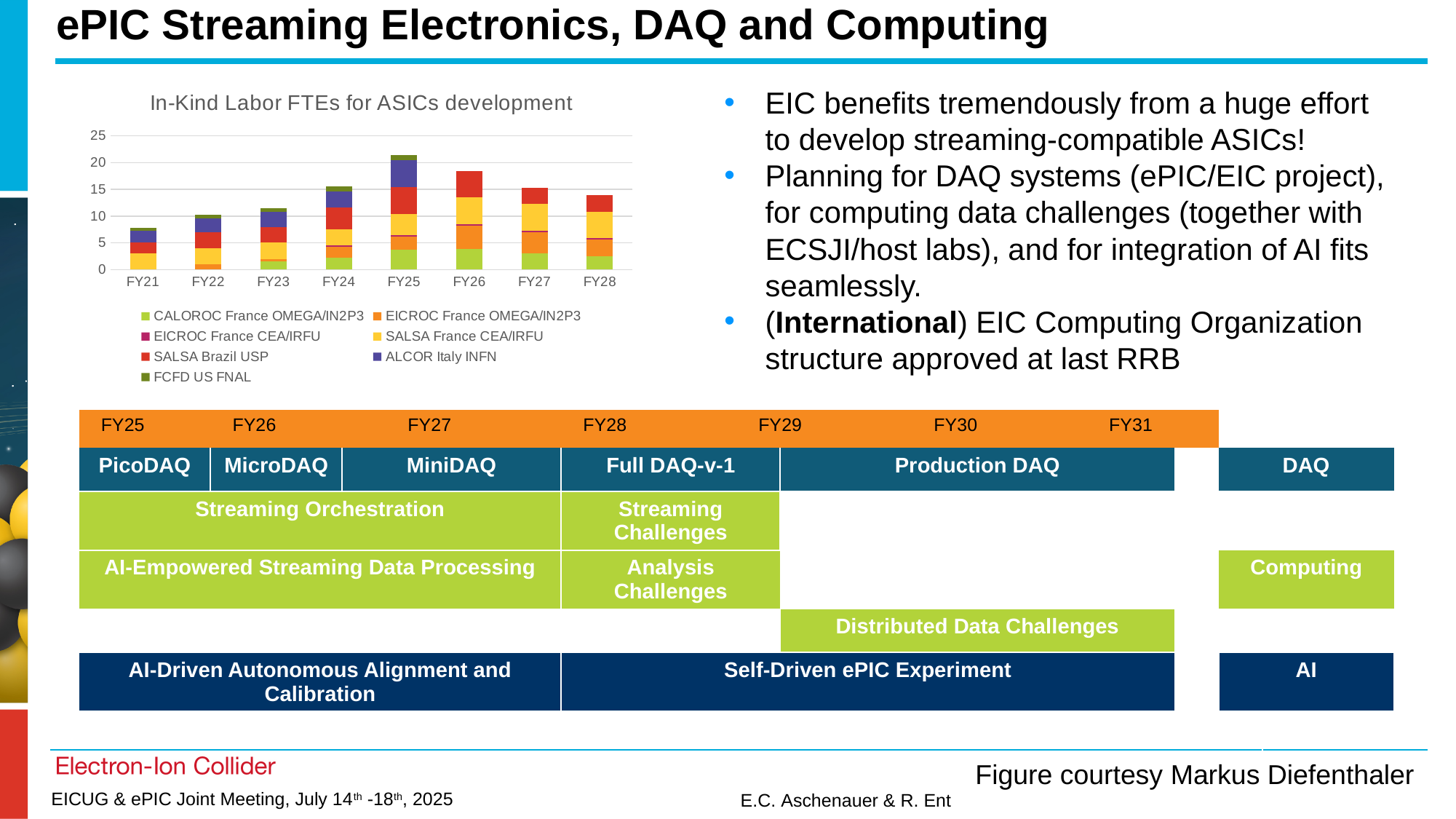
Is the total value for FY21 greater or less than 10? less Which legend entry is shown in purple? ALCOR Italy INFN Is the total value for FY26 greater or less than 15? greater Do the total FTEs rise or fall from FY21 to FY25? rise How many fiscal years are shown on the x axis of the chart? 8 How many series does the chart's legend list? 7 Which fiscal year has the lowest total in-kind labor FTEs? FY21 What is the title of the chart? In-Kind Labor FTEs for ASICs development Which fiscal year has the highest total in-kind labor FTEs? FY25 Which has a larger total, FY26 or FY27? FY26 What kind of chart is shown on the slide? stacked bar chart Is the total value for FY25 greater or less than 20? greater